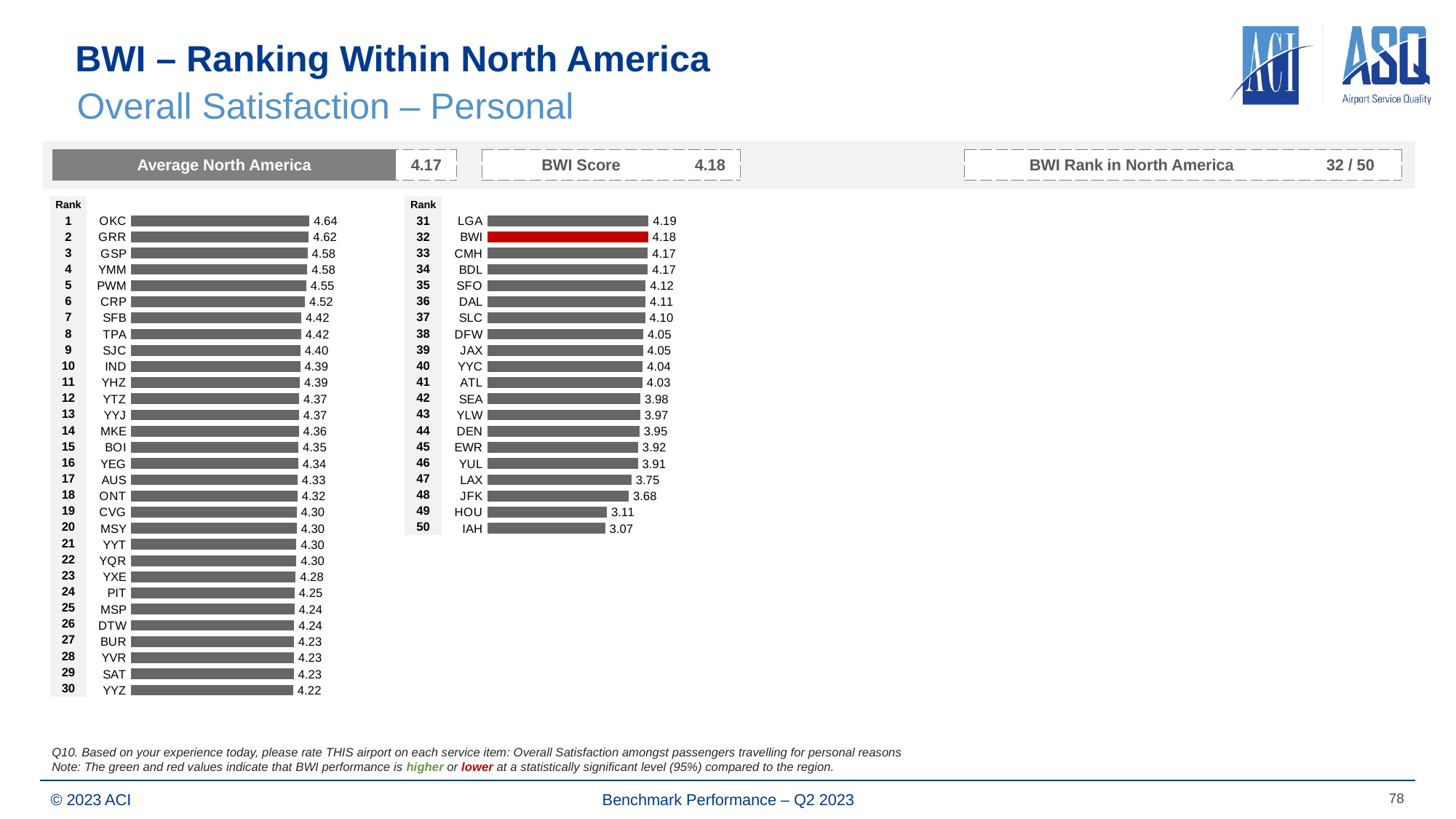
On the right chart (ranks 31–50), what is the difference between the values for BWI and IAH? 1.11 On the left chart (ranks 1–30), which airport has the highest value? OKC On the left chart (ranks 1–30), what is the value for OKC? 4.64 On the right chart (ranks 31–50), which airport has the lowest value? IAH What type of chart is used on this slide to show the airport rankings? Bar chart On the left chart (ranks 1–30), what is the difference between the values for OKC and YYZ? 0.42 How many airports are plotted on the left chart (ranks 1–30)? 30 On the right chart (ranks 31–50), which bar is highlighted in red? BWI On the right chart (ranks 31–50), which has a larger value, JFK or HOU? JFK How many airports are plotted on the right chart (ranks 31–50)? 20 On the right chart (ranks 31–50), what is the value for LAX? 3.75 On the right chart (ranks 31–50), what is the value for BWI? 4.18